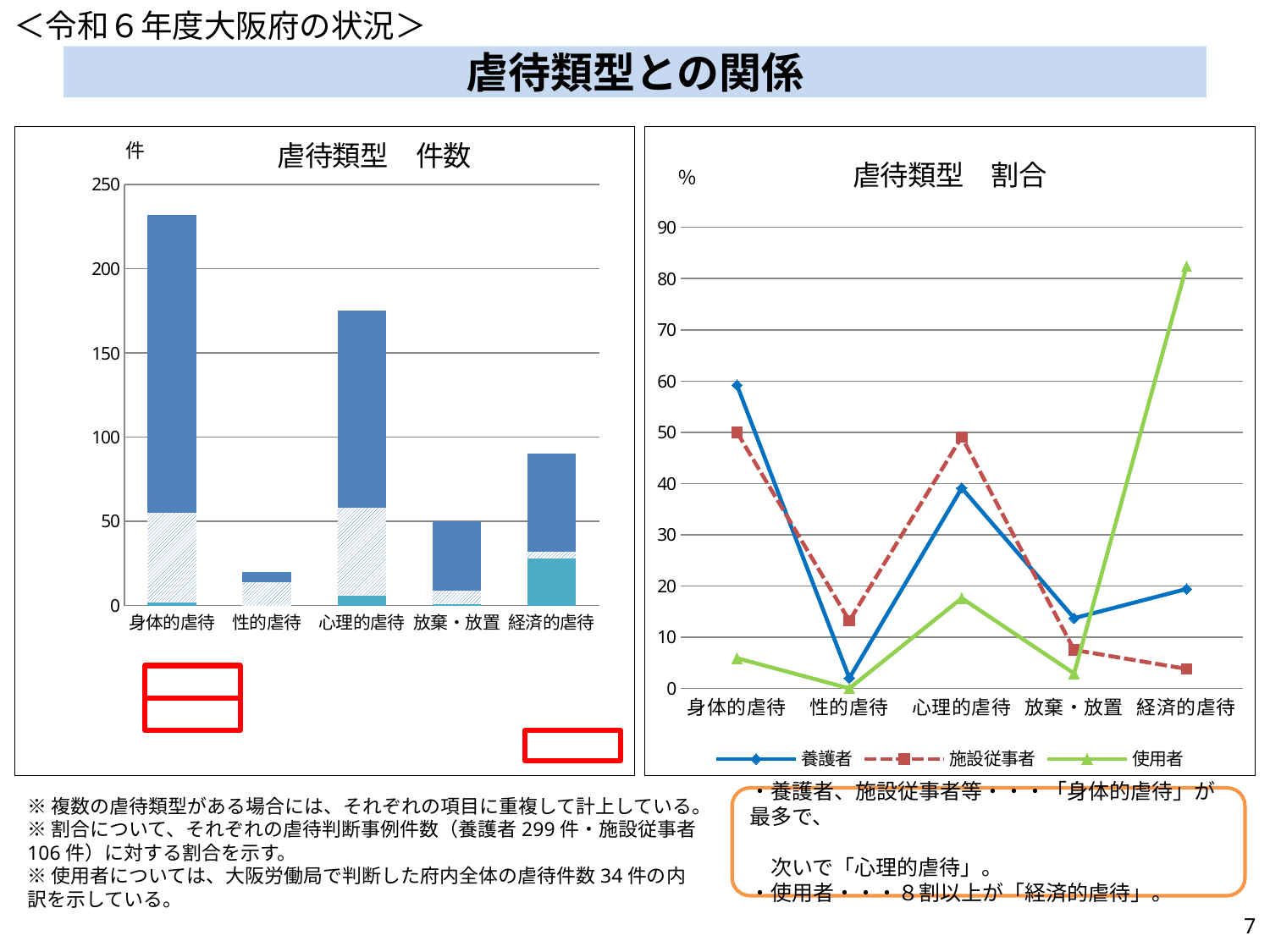
In the chart titled 虐待類型 件数 on the left, is the total bar for 身体的虐待 greater or less than 200? greater In the chart titled 虐待類型 件数 on the left, is the total bar for 経済的虐待 greater or less than 100? less In the chart titled 虐待類型 割合 on the right, which is larger for 身体的虐待: 養護者 or 施設従事者? 養護者 In the chart titled 虐待類型 割合 on the right, for which category is the 使用者 series highest? 経済的虐待 In the chart titled 虐待類型 割合 on the right, how many series does the legend list? 3 In the chart titled 虐待類型 割合 on the right, for which category is the 養護者 series highest? 身体的虐待 In the chart titled 虐待類型 割合 on the right, is the 使用者 value for 経済的虐待 greater or less than 80? greater In the chart titled 虐待類型 件数 on the left, how many categories are shown on the x axis? 5 What kind of chart is the chart titled 虐待類型 割合 on the right? line chart In the chart titled 虐待類型 件数 on the left, which category has the tallest bar? 身体的虐待 In the chart titled 虐待類型 件数 on the left, which category has the shortest bar? 性的虐待